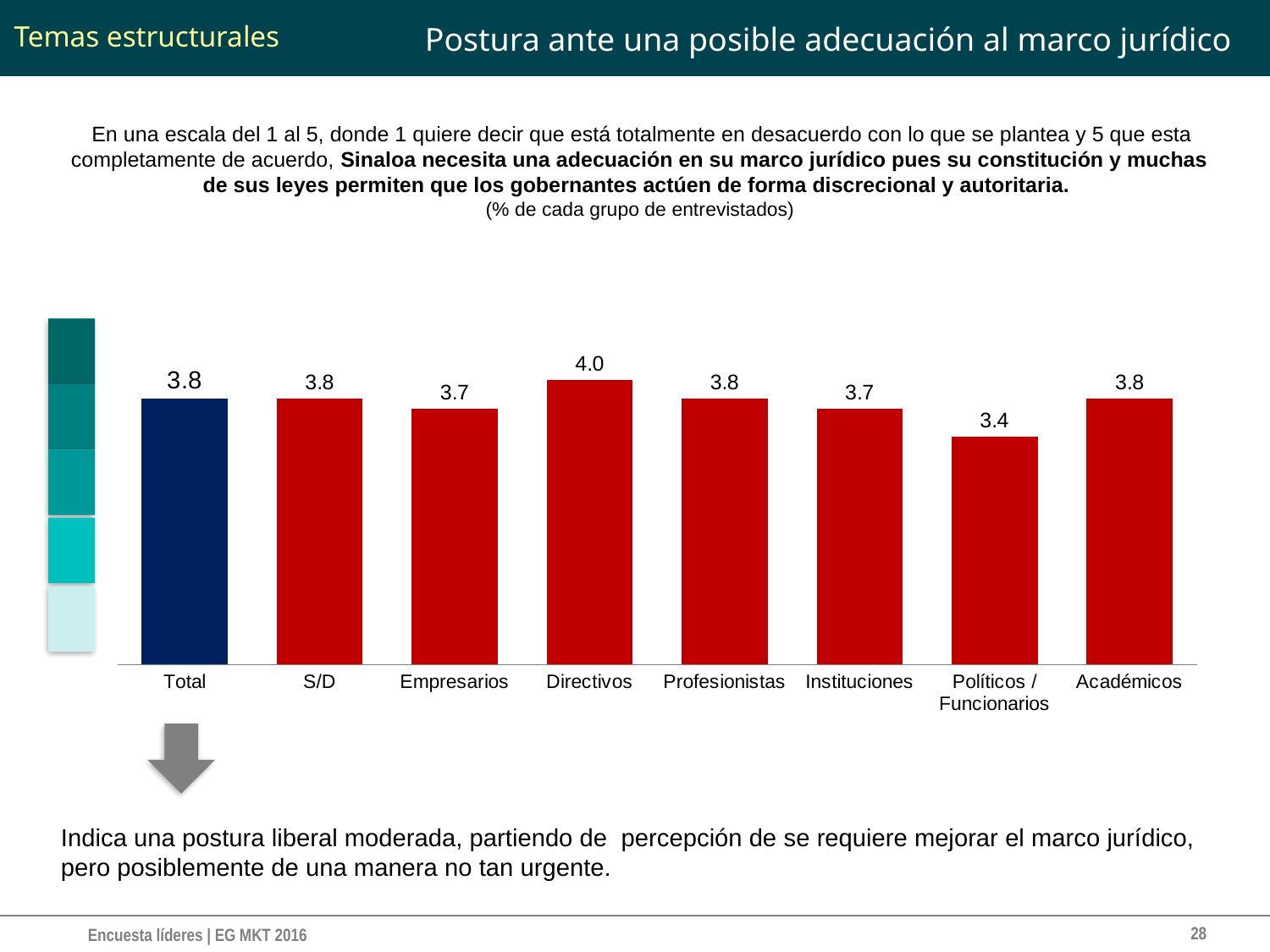
Which is larger, the value for Directivos or the value for Profesionistas? Directivos What is the value for Total? 3.8 What is the value for Directivos? 4.0 What is the value for Empresarios? 3.7 How many categories are shown on the x axis? 8 What kind of chart is shown on the slide? Bar chart Which category has the highest value? Directivos What is the difference between the values for Académicos and Instituciones? 0.1 Which bar is shown in a different colour (dark blue) from the others? Total What is the difference between the values for Directivos and Políticos / Funcionarios? 0.6 What is the value for Políticos / Funcionarios? 3.4 Which category has the lowest value? Políticos / Funcionarios